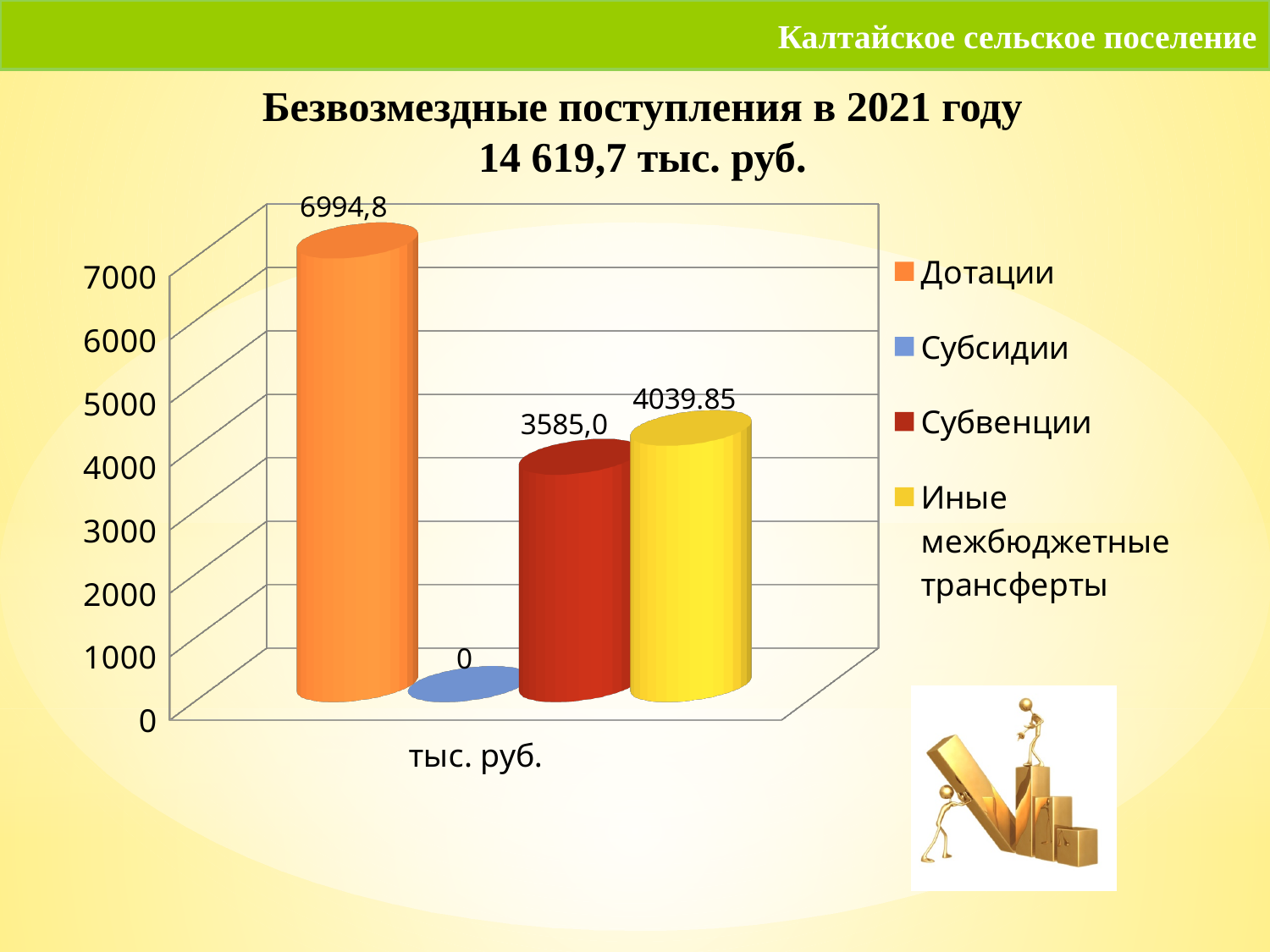
Which series has the highest value? Дотации Which is larger, the value for Субвенции or the value for Иные межбюджетные трансферты? Иные межбюджетные трансферты Which series has the lowest value? Субсидии How many series does the legend list? 4 What is the title of the chart? Безвозмездные поступления в 2021 году 14 619,7 тыс. руб. What is the value for Дотации? 6994,8 What is the difference between the values for Иные межбюджетные трансферты and Субвенции? 454.85 What is the value for Субсидии? 0 What is the value for Субвенции? 3585,0 What is the value for Иные межбюджетные трансферты? 4039.85 What is the difference between the values for Дотации and Субвенции? 3409,8 What kind of chart is shown on the slide? bar chart